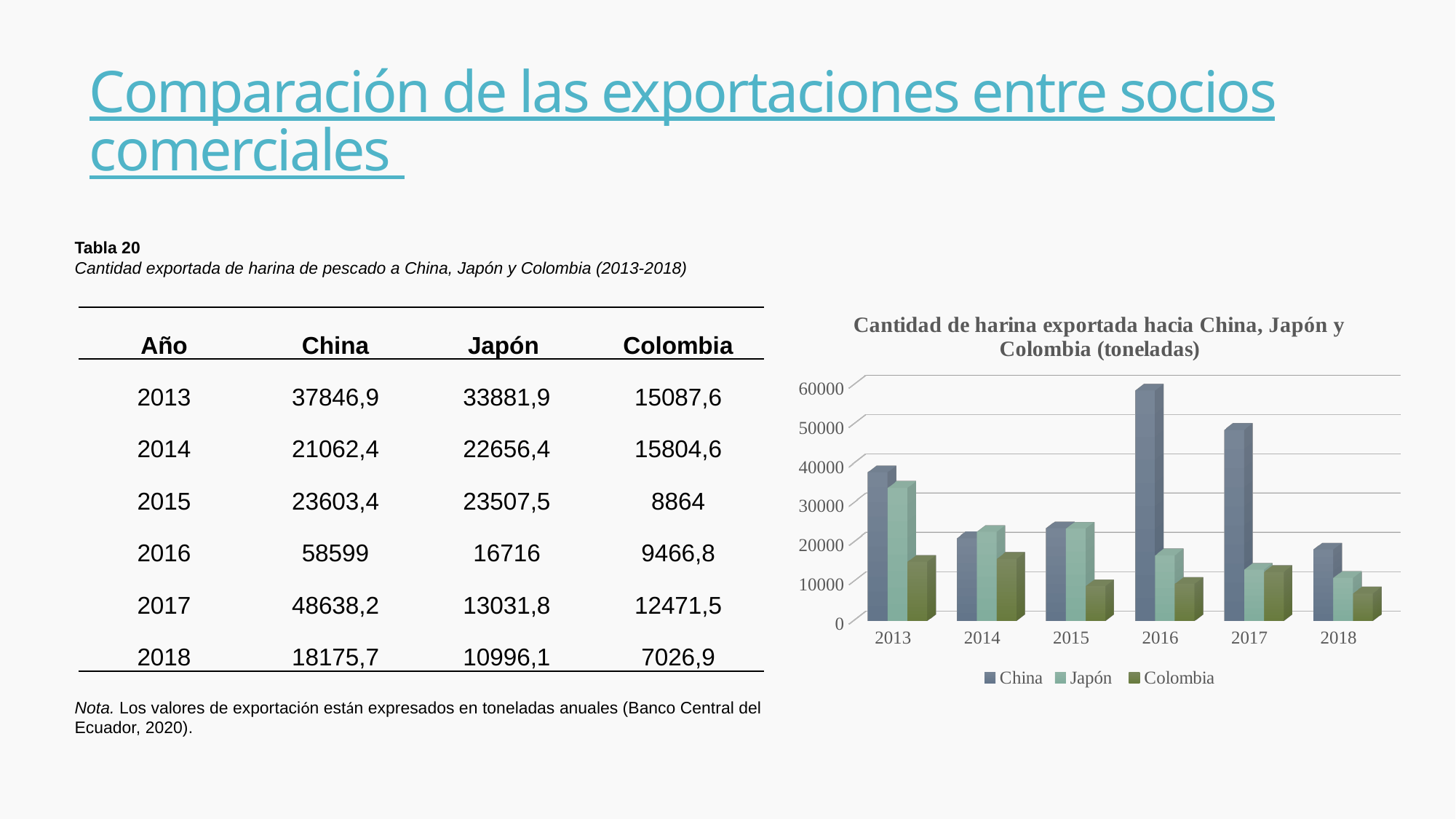
According to the slide, how many toneladas were exported to China in 2016? 58599 How many years are shown along the x axis of the chart? 6 Which is larger in 2013, the bar for China or the bar for Colombia? China In which year is the China bar highest in the chart? 2016 Is the value for China in 2016 greater or less than 50000? greater In which year is the Colombia bar lowest in the chart? 2018 According to the slide, how many toneladas were exported to Japón in 2013? 33881,9 How many series does the chart legend list? 3 What is the title of the chart? Cantidad de harina exportada hacia China, Japón y Colombia (toneladas) What kind of chart is shown on the right of the slide? bar chart Do the Japón values rise or fall from 2015 to 2018 in the chart? fall Is the value for Japón in 2017 greater or less than 20000? less